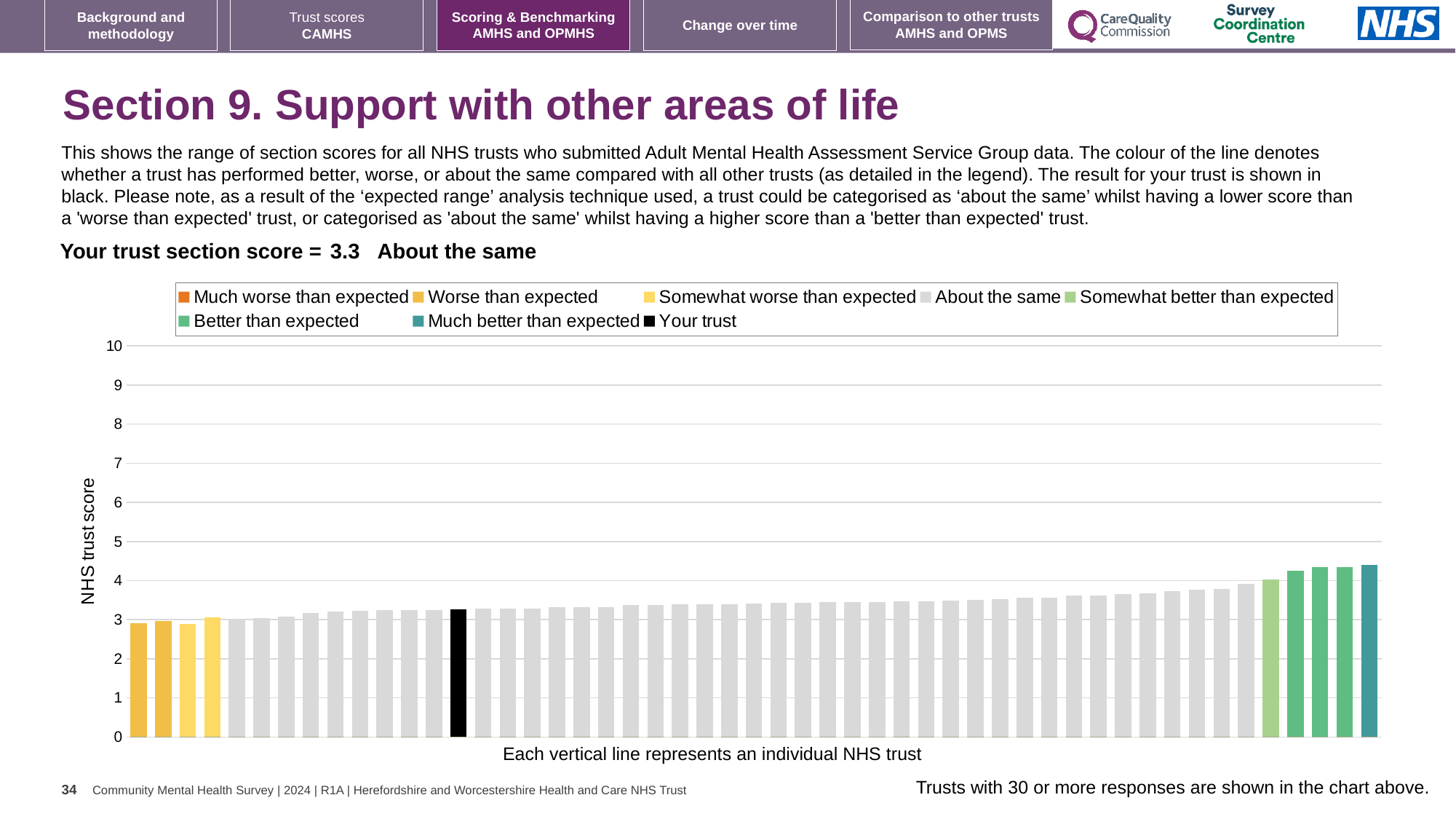
Is the value for your trust greater or less than 2? greater How many entries does the chart legend list? 8 Do the bar values rise or fall from left to right along the x axis? Rise Which legend category do the tallest bars on the right of the chart belong to? Much better than expected What is the label on the vertical axis of the chart? NHS trust score Is the value for the tallest bar greater or less than 4? greater What kind of chart is shown on the slide? Bar chart What colour is used for the bar representing your trust? Black Is the value for your trust greater or less than 5? less Which is larger, the leftmost bar or the rightmost bar? The rightmost bar What is your trust's section score for Section 9, Support with other areas of life? 3.3 How is your trust's section score categorised compared with other trusts? About the same